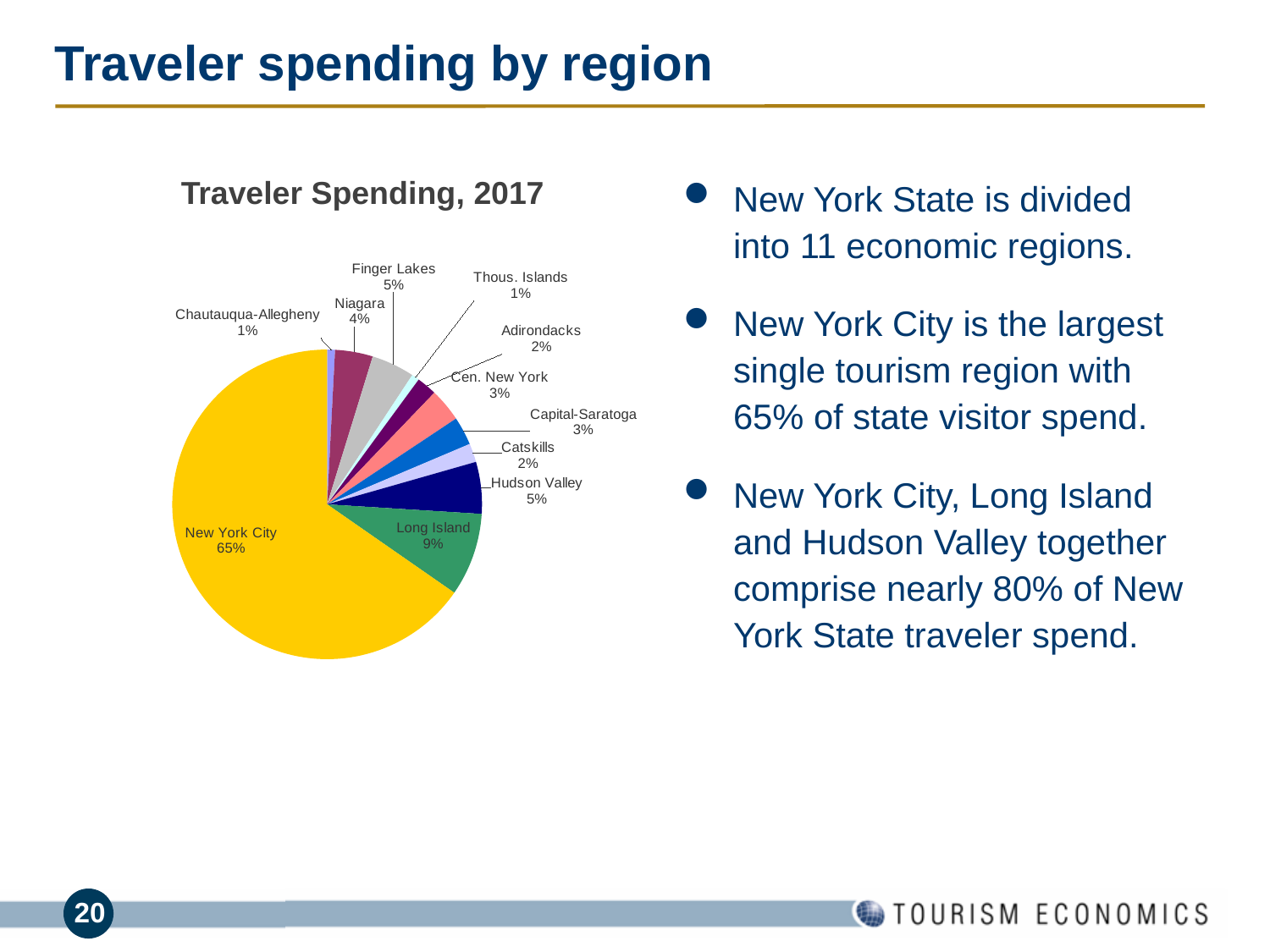
What is the value shown for Niagara? 4% What type of chart is shown on the slide? Pie chart What is the value shown for Capital-Saratoga? 3% Which region has the largest slice of the pie? New York City What is the combined share of New York City, Long Island and Hudson Valley? 79% How many regions (slices) are shown in the pie chart? 11 Which is larger, the share for Finger Lakes or the share for Niagara? Finger Lakes What share of traveler spending does New York City account for? 65% What is the title of the chart? Traveler Spending, 2017 What is the value shown for Long Island? 9% What percentage is shown for Hudson Valley? 5% What is the difference in percentage points between Long Island and Hudson Valley? 4